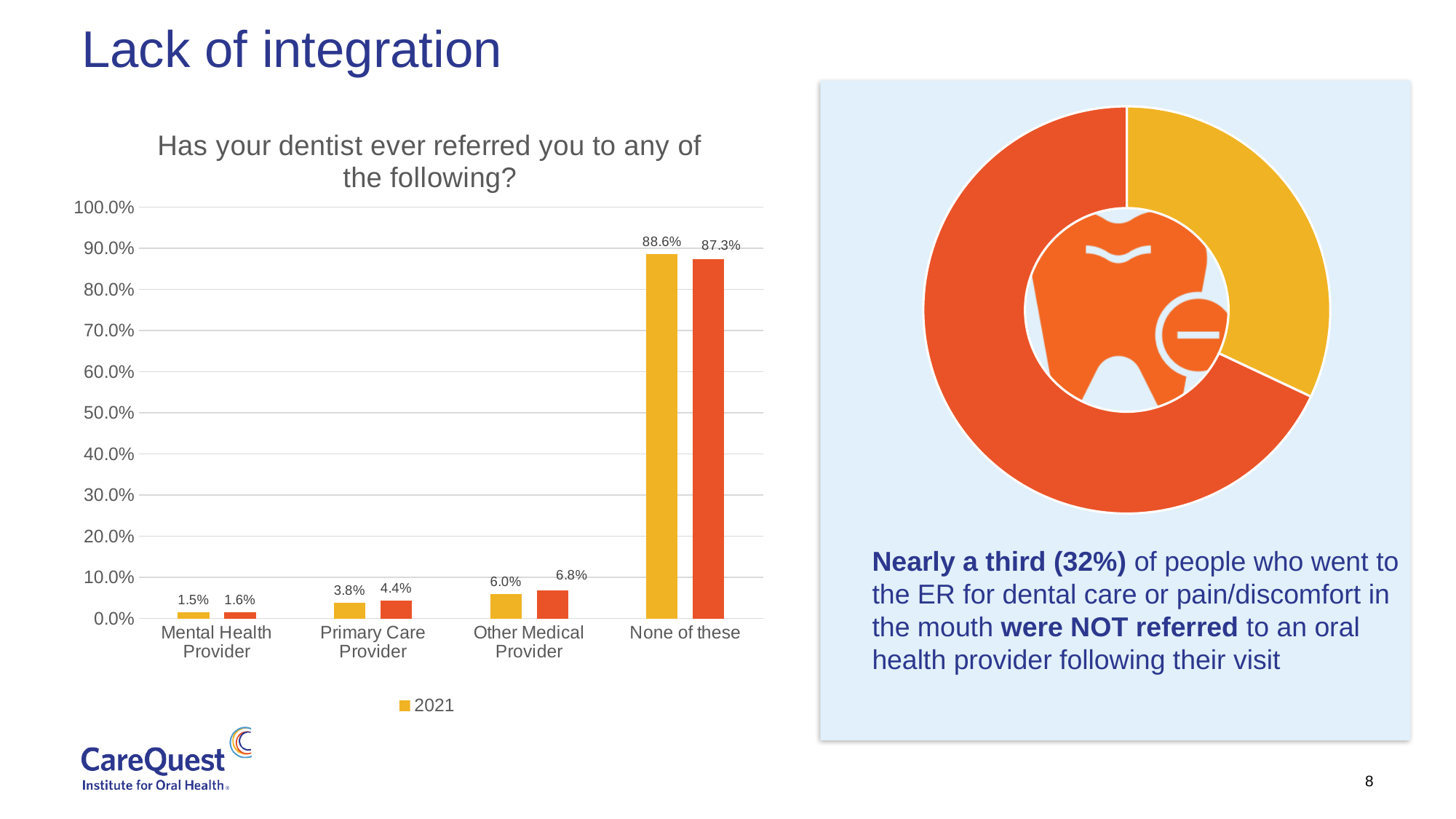
In the bar chart, what is the 2021 value for "None of these"? 88.6% In the bar chart, what is the 2021 value for Primary Care Provider? 3.8% In the bar chart, which category has the highest 2021 value? None of these In the bar chart, what is the 2021 value for Other Medical Provider? 6.0% In the bar chart, what is the difference between the 2021 values for Other Medical Provider and Primary Care Provider? 2.2% In the bar chart, what value is printed on the orange bar for "None of these"? 87.3% In the bar chart, which has the larger 2021 value: Primary Care Provider or Other Medical Provider? Other Medical Provider How many categories are shown on the x axis of the bar chart? 4 What type of chart is used for "Has your dentist ever referred you to any of the following?"? Bar chart In the bar chart, which category has the lowest 2021 value? Mental Health Provider In the bar chart, what is the 2021 value for Mental Health Provider? 1.5% How many series does the legend of the bar chart list? 1